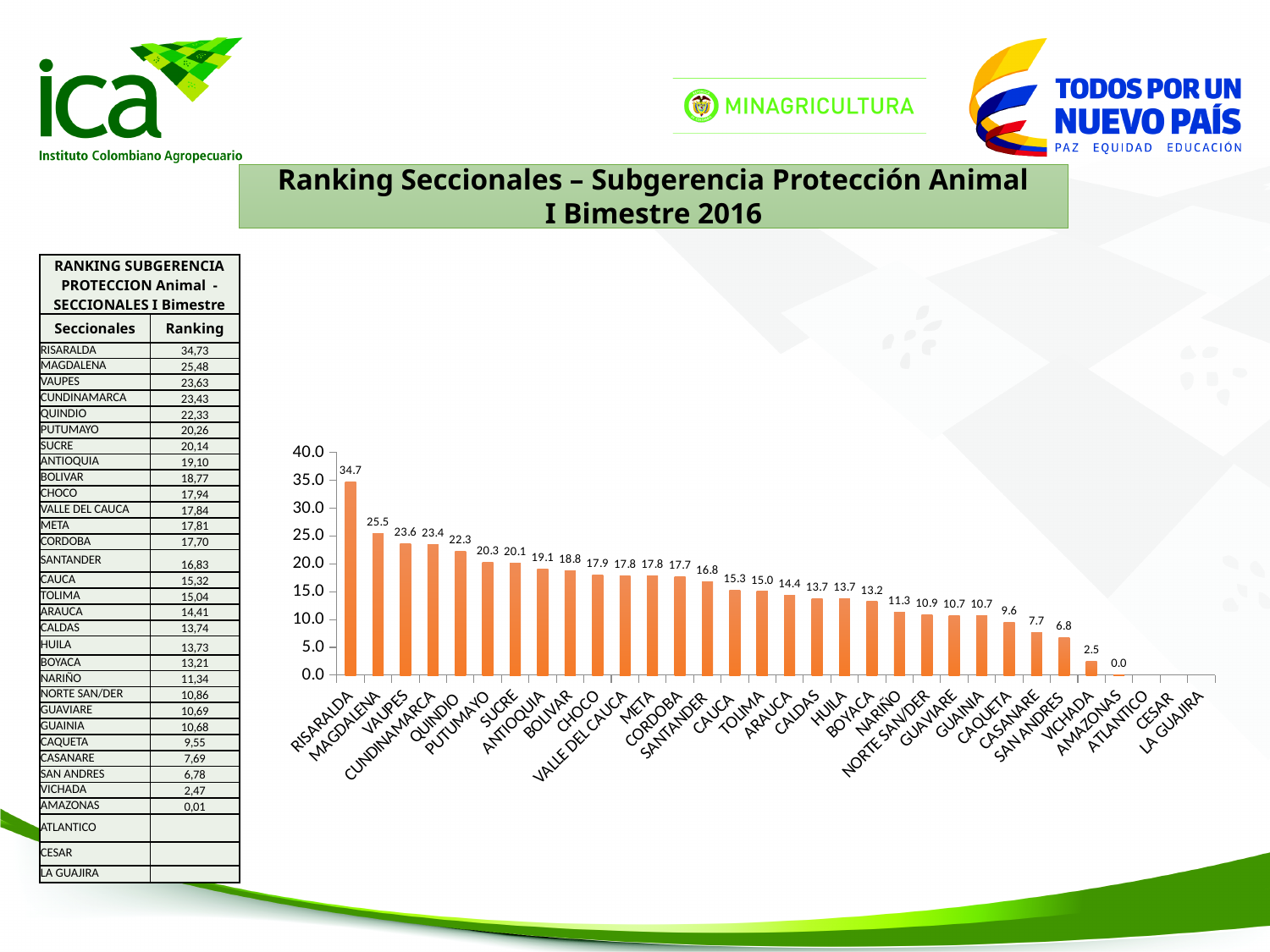
What is the value shown for AMAZONAS? 0.0 What is the difference between the values for RISARALDA and MAGDALENA? 9.2 Do the values rise or fall moving from left to right along the x axis? fall What is the value shown for SANTANDER? 16.8 What is the value shown for MAGDALENA? 25.5 Which has a larger value, PUTUMAYO or CAUCA? PUTUMAYO What is the value shown for VICHADA? 2.5 Is the value for BOYACA greater or less than 15.0? less What colour are the bars in the chart? orange What type of chart is shown on the slide? bar chart Which category has the highest value in the chart? RISARALDA What is the value shown for RISARALDA? 34.7